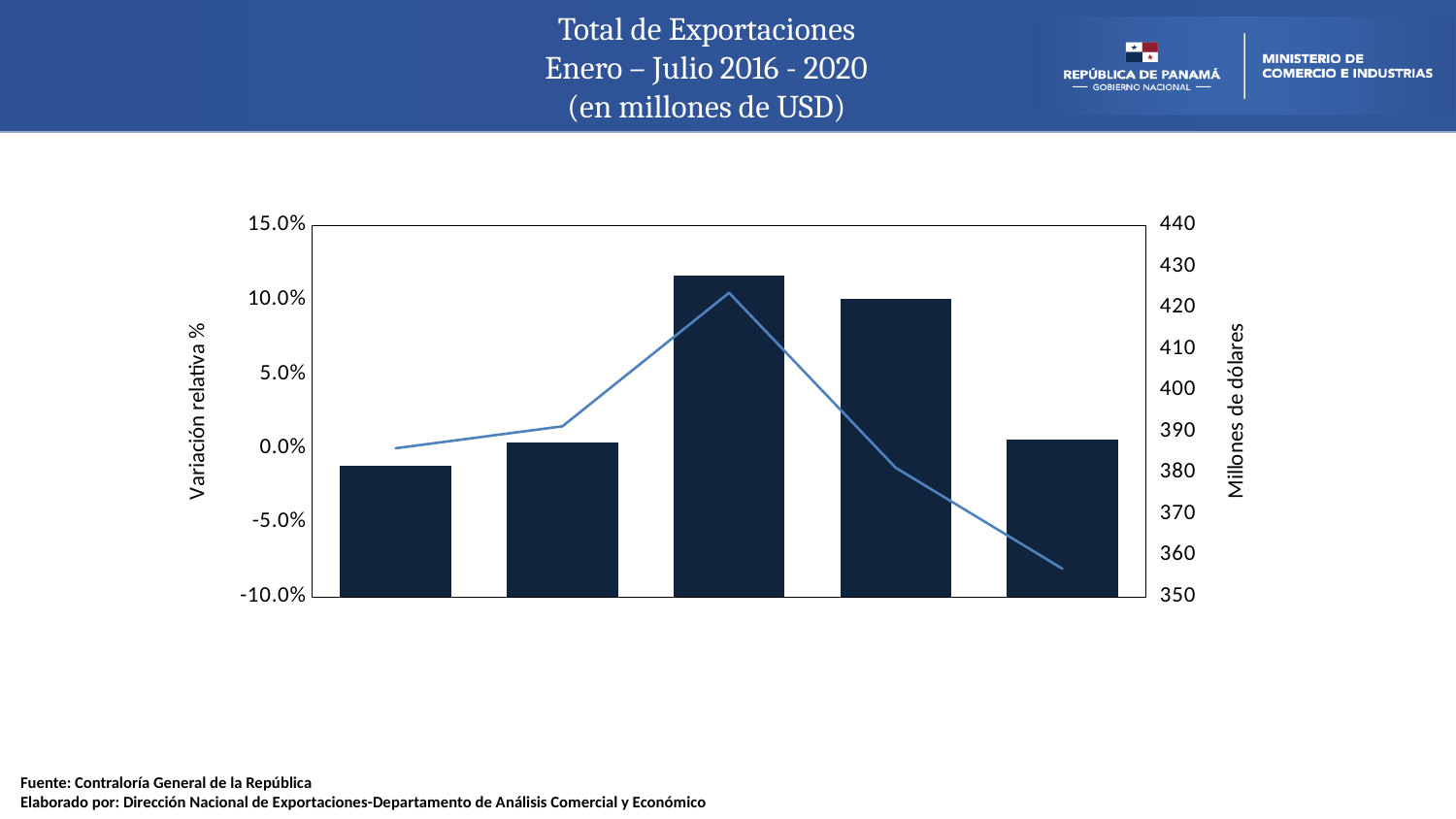
What is the title of the left vertical axis? Variación relativa % Which bar is the tallest in the chart, counting from the left? The third bar What kind of chart is shown on the slide? A combined bar and line chart How many bars are plotted in the chart? 5 Which is taller, the fourth bar from the left or the second bar from the left? The fourth bar What is the highest tick value shown on the right vertical axis? 440 Which is taller, the third bar from the left or the fifth bar from the left? The third bar At which bar position, counting from the left, does the line reach its highest point? The third Does the line rise or fall between the first and third positions along the x axis? Rise What is the title of the chart on the slide? Total de Exportaciones Enero – Julio 2016 - 2020 (en millones de USD) Which bar is the shortest in the chart, counting from the left? The first bar Does the line rise or fall between the third and fifth positions along the x axis? Fall